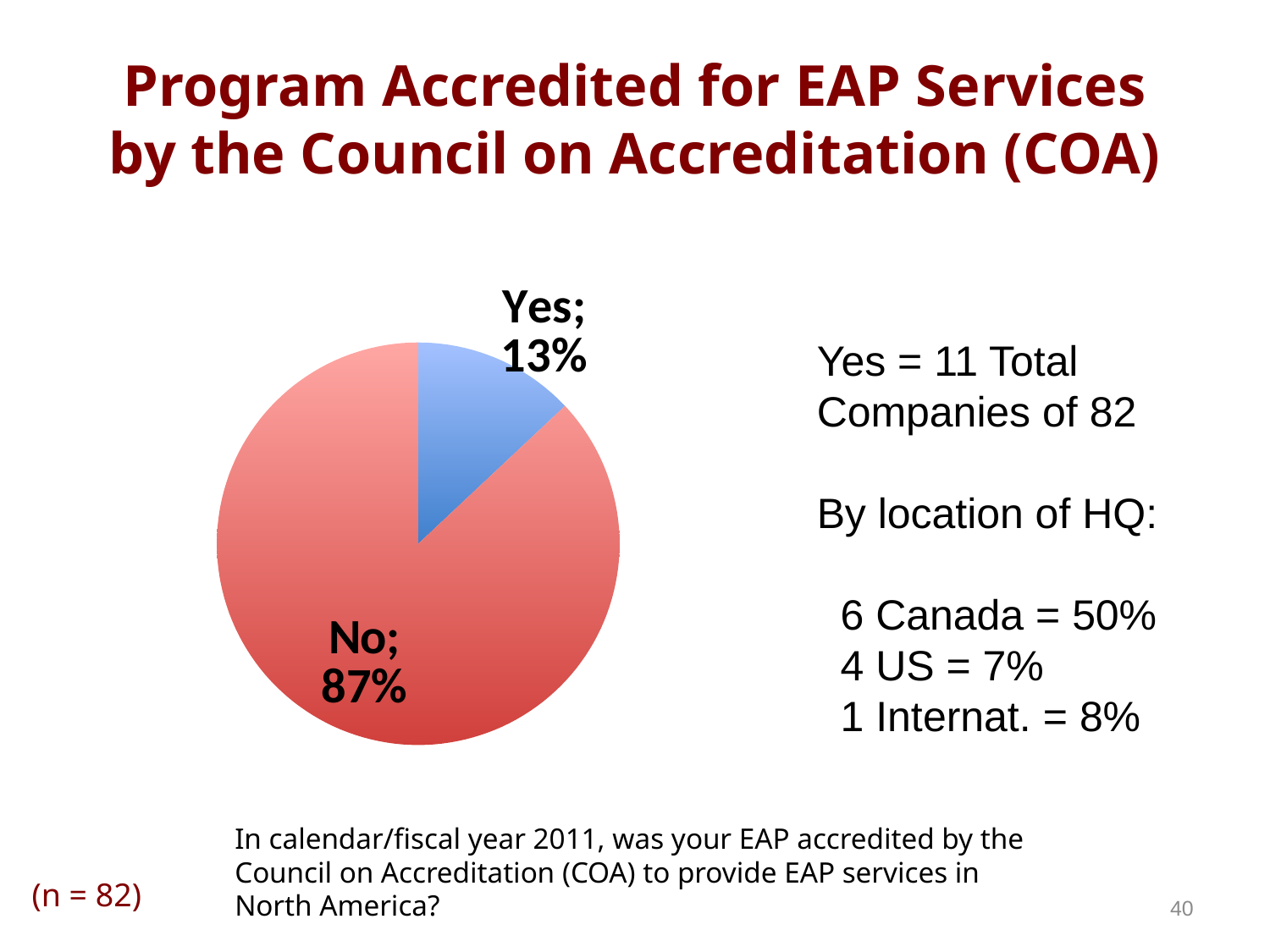
What percentage of the pie is labelled "Yes"? 13% Which slice of the pie is the smallest? Yes Which slice of the pie is the largest? No What percentage of the pie is labelled "No"? 87% What colour is the "No" slice of the pie? red What share of the pie does the "Yes" slice represent? 13% How many slices does the pie chart have? 2 Which slice is larger, "Yes" or "No"? No What is the difference in percentage points between the "No" slice and the "Yes" slice? 74 What colour is the "Yes" slice of the pie? blue What kind of chart is shown on the slide? pie chart